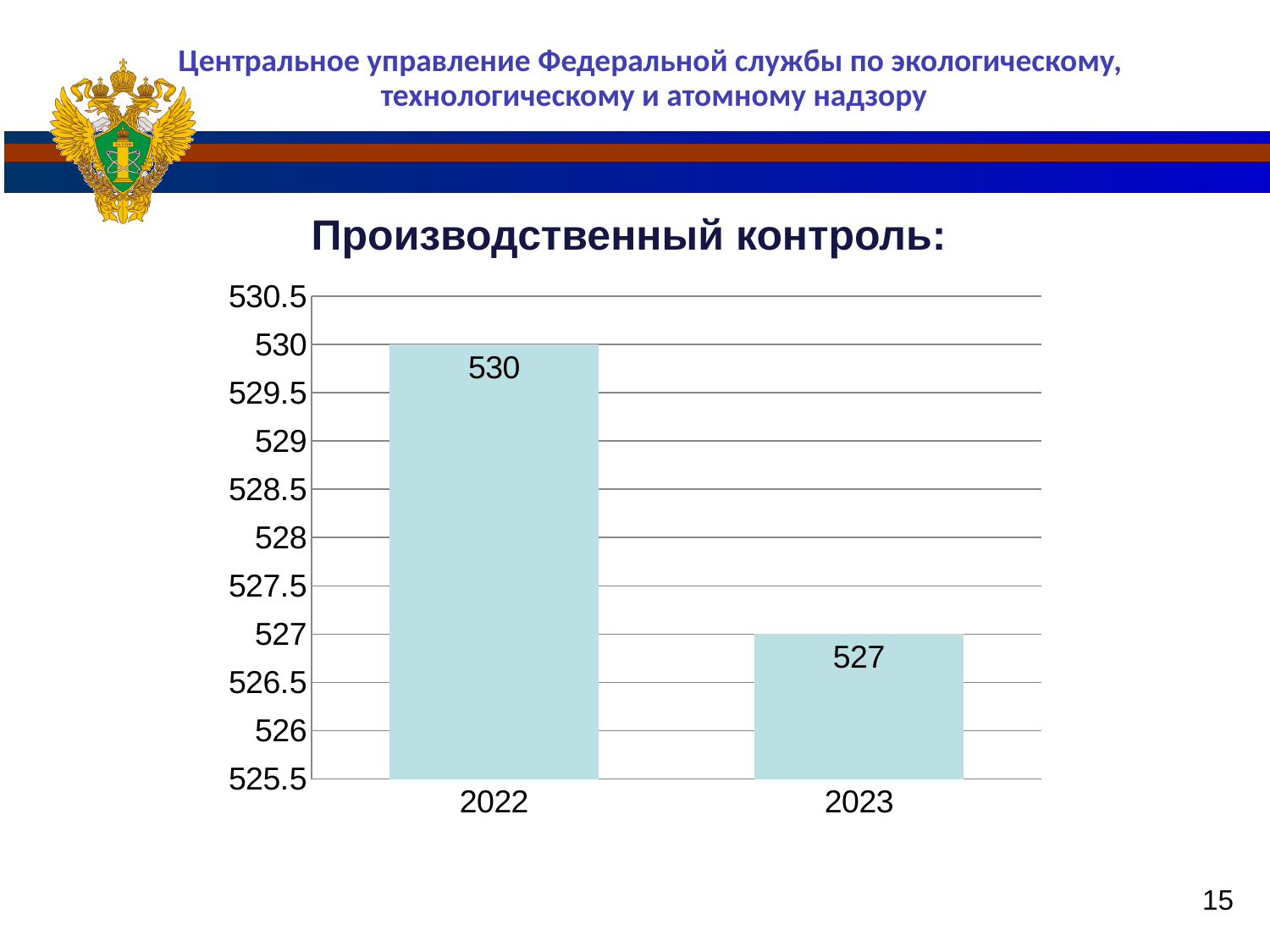
What kind of chart is shown on the slide? bar chart Which year has the highest value? 2022 Do the values rise or fall from 2022 to 2023? fall What is the value for 2022? 530 How many categories are shown on the x axis? 2 Is the value for 2023 greater or less than 528? less Which year has the lowest value? 2023 Is the value for 2022 greater or less than 529? greater What is the value for 2023? 527 What is the difference between the values for 2022 and 2023? 3 What is the title of the chart? Производственный контроль: Which is larger, the value for 2022 or the value for 2023? 2022